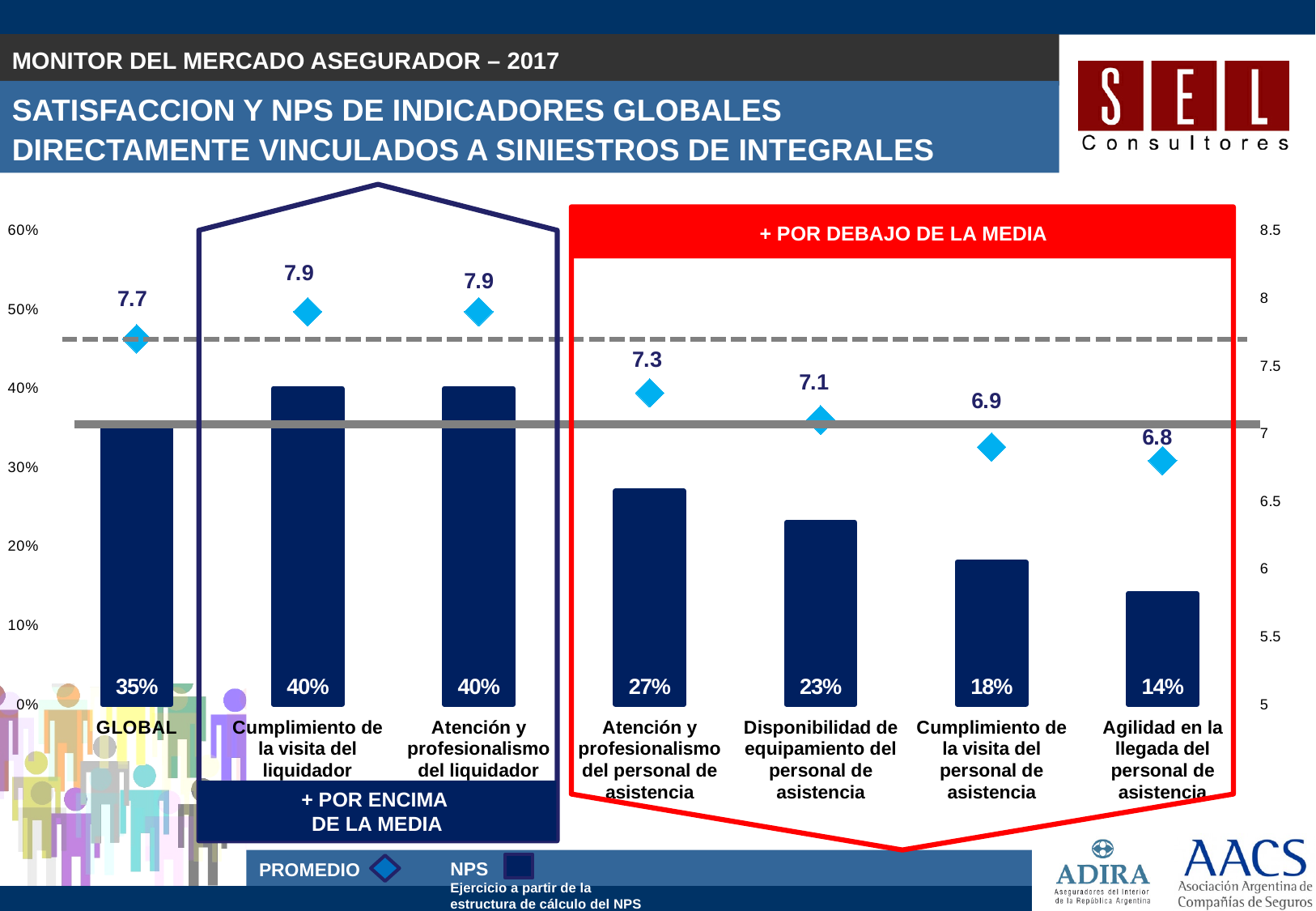
What is the difference in NPS between Cumplimiento de la visita del liquidador and Cumplimiento de la visita del personal de asistencia? 22% How many categories are shown on the x axis of the chart? 7 What is the PROMEDIO value for Agilidad en la llegada del personal de asistencia? 6.8 How many series does the legend list? 2 What is the difference in PROMEDIO between GLOBAL and Disponibilidad de equipamiento del personal de asistencia? 0.6 Which series in the legend is represented by the diamond marker? PROMEDIO Which has a higher NPS value, GLOBAL or Atención y profesionalismo del personal de asistencia? GLOBAL What is the NPS value for GLOBAL? 35% Which category has the lowest NPS value? Agilidad en la llegada del personal de asistencia What is the NPS value for Disponibilidad de equipamiento del personal de asistencia? 23% What is the PROMEDIO value for Atención y profesionalismo del personal de asistencia? 7.3 Which category has the lowest PROMEDIO value? Agilidad en la llegada del personal de asistencia